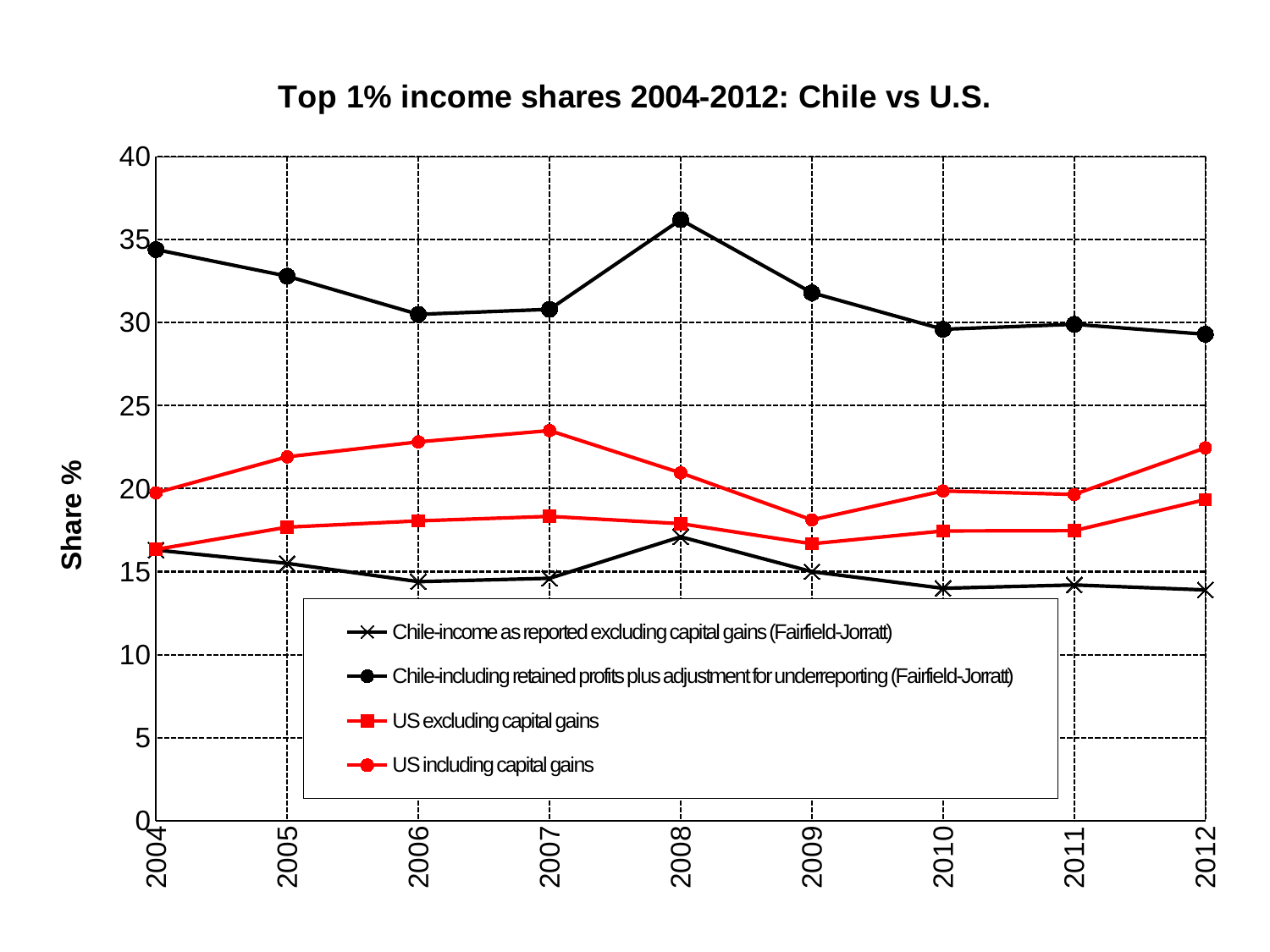
In 2004, which series has the higher value: 'Chile-including retained profits plus adjustment for underreporting (Fairfield-Jorratt)' or 'US including capital gains'? Chile-including retained profits plus adjustment for underreporting (Fairfield-Jorratt) Is the value for 'Chile-income as reported excluding capital gains (Fairfield-Jorratt)' in 2012 greater or less than 15? less What is the title of the chart? Top 1% income shares 2004-2012: Chile vs U.S. Does the 'Chile-including retained profits plus adjustment for underreporting (Fairfield-Jorratt)' series rise or fall from 2008 to 2010? fall Is the value for 'Chile-including retained profits plus adjustment for underreporting (Fairfield-Jorratt)' in 2008 greater or less than 35? greater In which year does the 'Chile-including retained profits plus adjustment for underreporting (Fairfield-Jorratt)' series reach its highest value? 2008 How many years are plotted along the x axis? 9 Is the value for 'US excluding capital gains' in 2004 greater or less than 20? less In which year does the 'Chile-income as reported excluding capital gains (Fairfield-Jorratt)' series reach its highest value? 2008 In which year does the 'US including capital gains' series reach its lowest value? 2009 What kind of chart is shown on the slide? line chart How many series does the legend list? 4